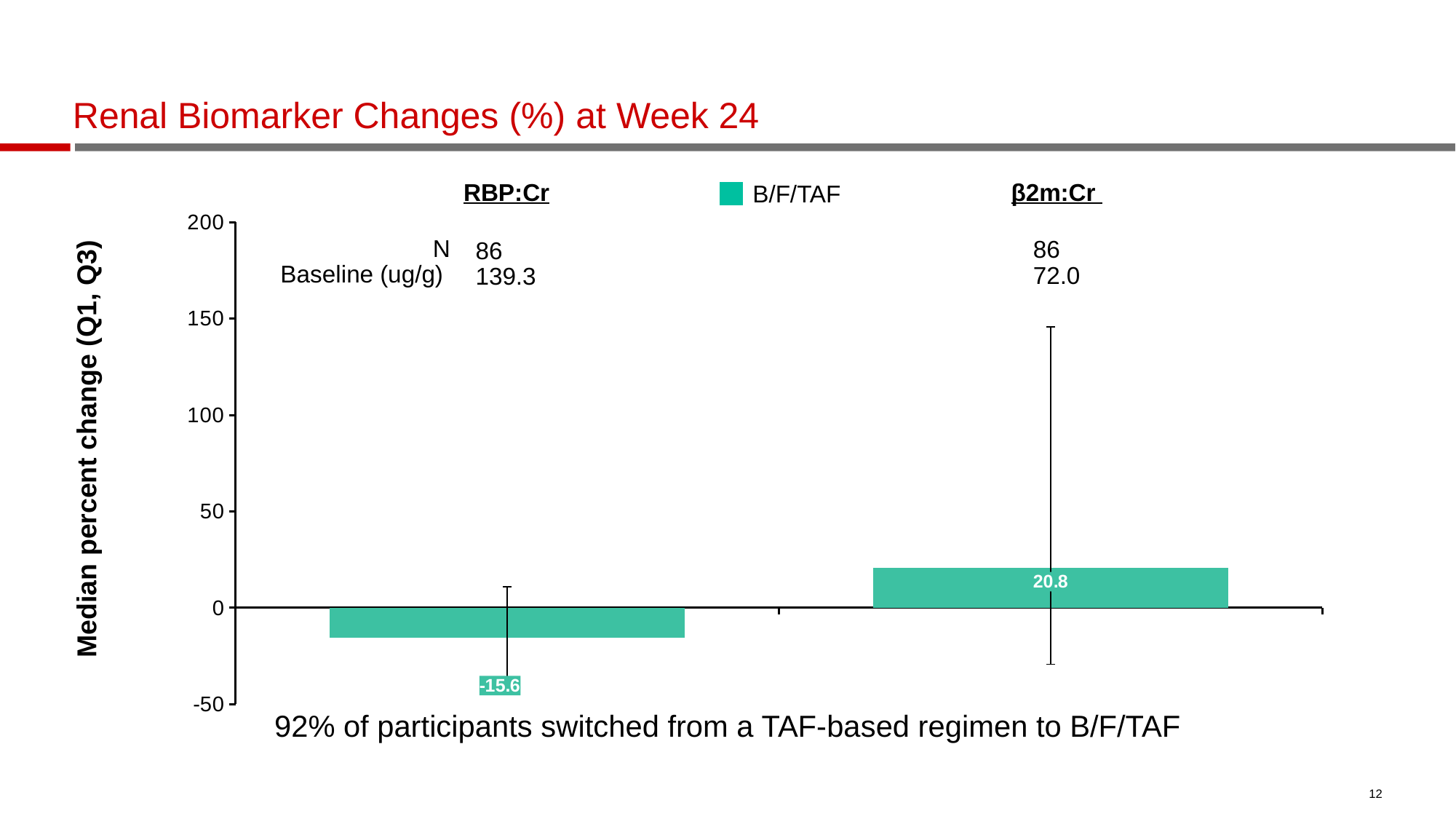
What treatment does the legend entry name? B/F/TAF How many series does the legend list? 1 What is the median percent change for β2m:Cr? 20.8 Is the median percent change for β2m:Cr greater or less than 50? less Which biomarker has the lowest median percent change? RBP:Cr What is the median percent change for RBP:Cr? -15.6 What kind of chart is shown on the slide? bar chart What is the difference between the median percent change for β2m:Cr and RBP:Cr? 36.4 Is the median percent change for RBP:Cr greater or less than 0? less How many biomarkers are plotted on the chart? 2 Which biomarker has the higher median percent change, RBP:Cr or β2m:Cr? β2m:Cr What is the baseline value (ug/g) for RBP:Cr? 139.3